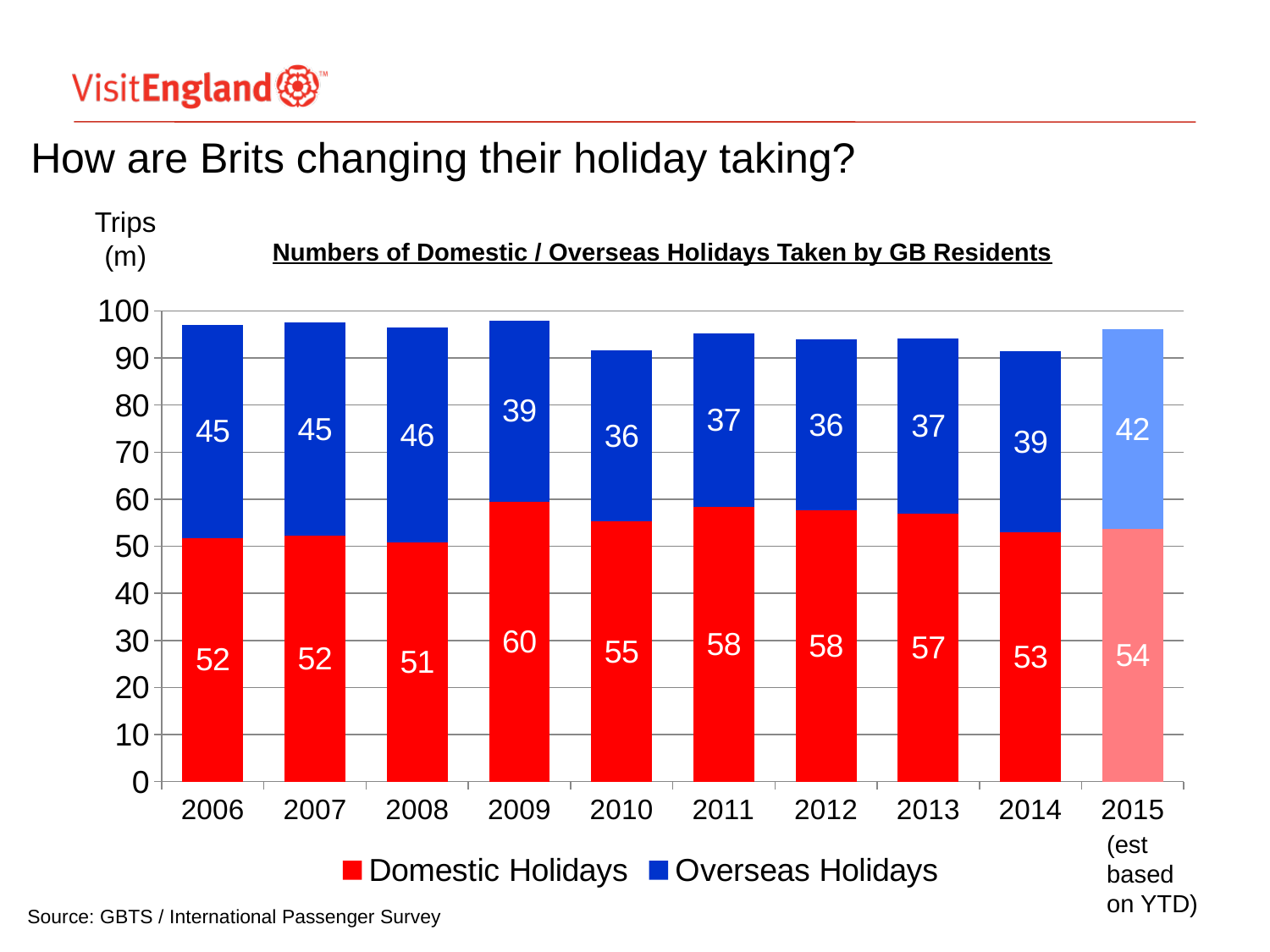
Which year has the lowest value for Domestic Holidays? 2008 How many years are shown on the x axis? 10 What kind of chart is shown on the slide? Stacked bar chart What is the value for Overseas Holidays in 2010? 36 Which year has the highest value for Domestic Holidays? 2009 What is the value for Domestic Holidays in 2009? 60 What is the difference between Domestic Holidays and Overseas Holidays in 2009? 21 Which is larger in 2006: Domestic Holidays or Overseas Holidays? Domestic Holidays What is the title of the chart? Numbers of Domestic / Overseas Holidays Taken by GB Residents What is the value for Overseas Holidays in 2015? 42 What is the total of the stacked bar for 2014? 92 How many series does the legend list? 2